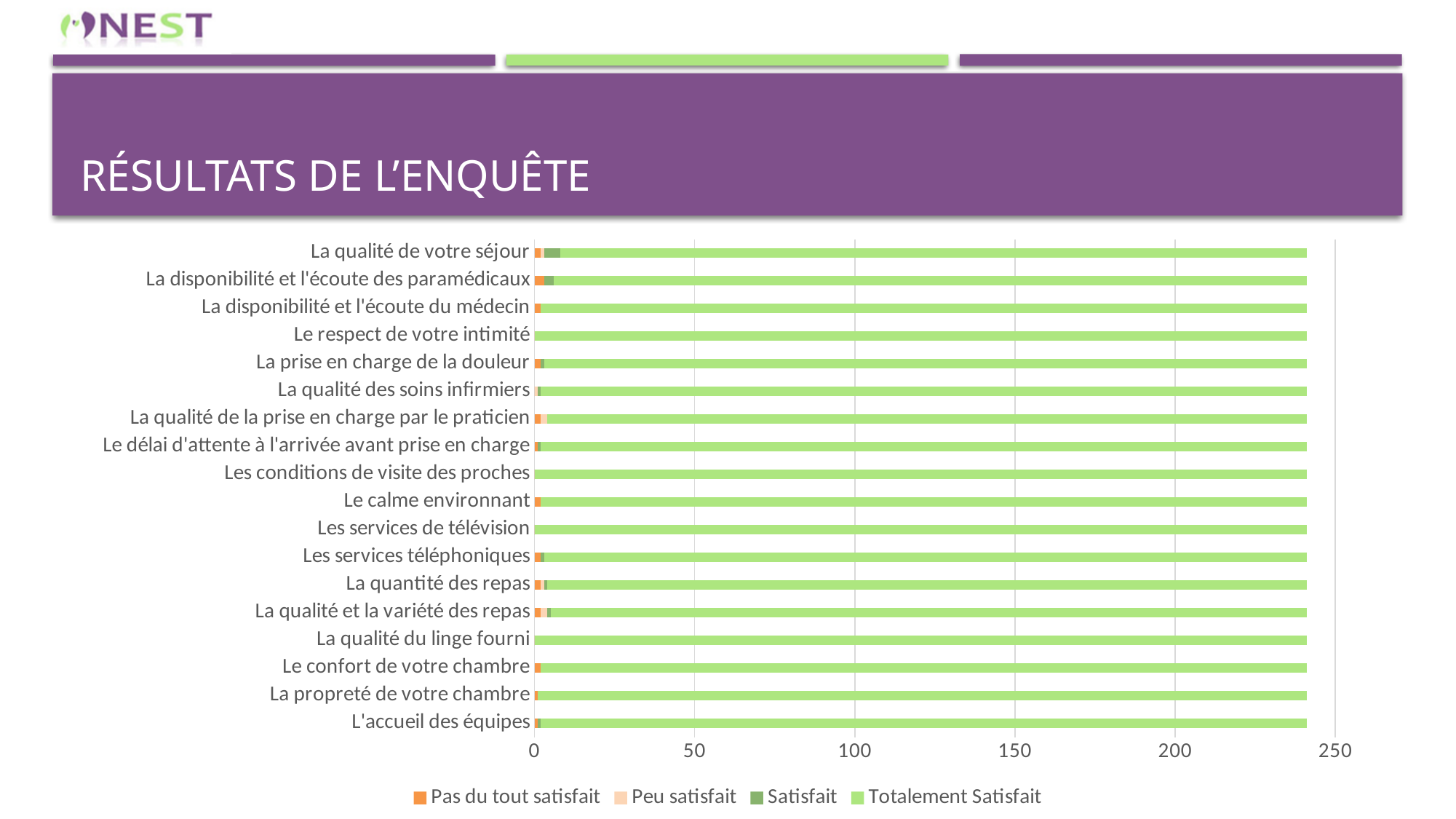
What is the highest value shown on the horizontal axis of the chart? 250 Is the total bar length for 'Les services de télévision' greater or less than 150? greater How many categories are listed on the vertical axis of the chart? 18 Is the 'Totalement Satisfait' value for 'La propreté de votre chambre' greater or less than 200? greater Which category has the largest 'Satisfait' segment in the chart? La qualité de votre séjour Is the 'Pas du tout satisfait' value for 'Le calme environnant' greater or less than 50? less How many series does the chart legend list? 4 What kind of chart is shown on the slide? Stacked bar chart Which series is listed first in the chart legend? Pas du tout satisfait Which series is shown in light green in the legend? Totalement Satisfait